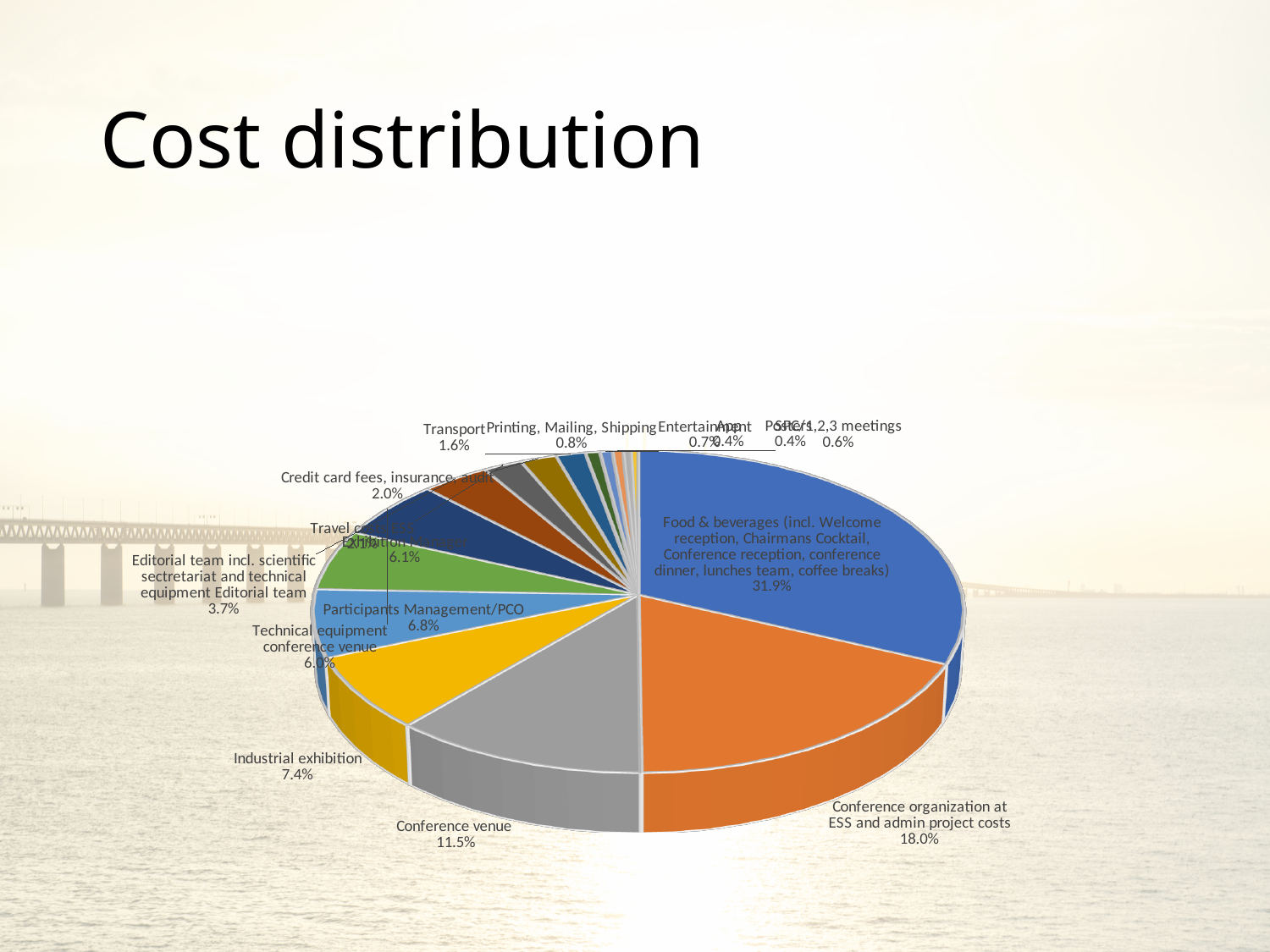
How many percentage points larger is the Food & beverages share than the Conference organization at ESS and admin project costs share? 13.9 percentage points What percentage is shown for Participants Management/PCO? 6.8% What is the title of the slide containing the chart? Cost distribution What share is shown for Credit card fees, insurance, audit? 2.0% What percentage is shown for Conference organization at ESS and admin project costs? 18.0% Which is larger, the share for Conference venue or the share for Industrial exhibition? Conference venue What kind of chart is shown on the slide? Pie chart What share is labelled for Industrial exhibition? 7.4% What share of costs is Food & beverages (incl. Welcome reception, Chairmans Cocktail, Conference reception, conference dinner, lunches team, coffee breaks)? 31.9% What percentage of the cost distribution is Conference venue? 11.5% What percentage is labelled for Transport? 1.6% Which category has the largest slice of the pie? Food & beverages (incl. Welcome reception, Chairmans Cocktail, Conference reception, conference dinner, lunches team, coffee breaks)